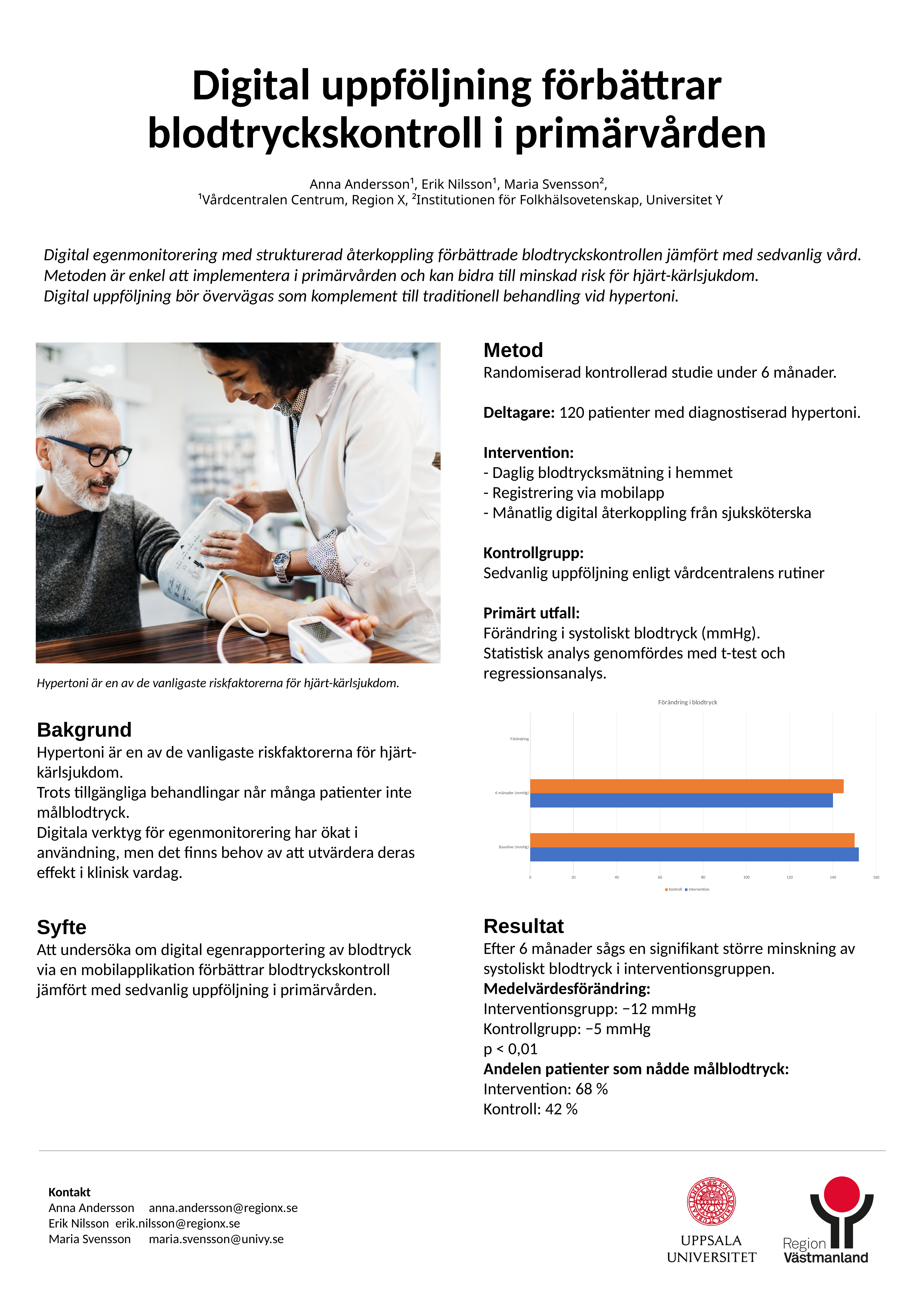
What is the title of the chart? Förändring i blodtryck What kind of chart is shown on the slide? Bar chart Which two series are listed in the chart legend? Kontroll and Intervention Is the Intervention value for Baseline (mmHg) greater or less than 160? less How many categories are shown on the vertical axis of the chart? 3 Do the Kontroll values rise or fall from Baseline (mmHg) to 6 månader (mmHg)? fall Is the Kontroll value for 6 månader (mmHg) greater or less than 140? greater Is the Kontroll value for Baseline (mmHg) greater or less than 140? greater How many series does the chart legend list? 2 Do the Intervention values rise or fall from Baseline (mmHg) to 6 månader (mmHg)? fall